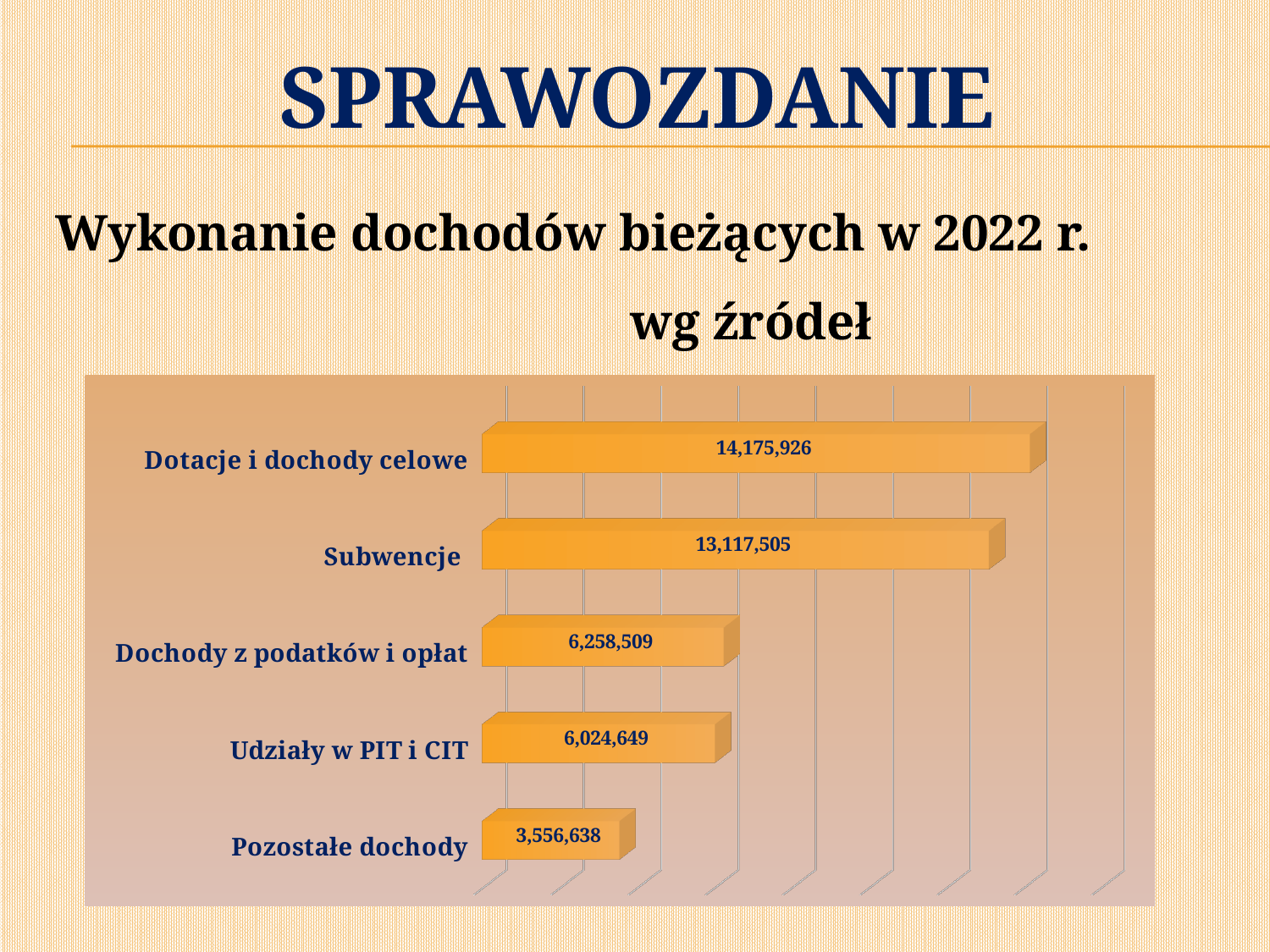
What is the difference between the values for Dochody z podatków i opłat and Udziały w PIT i CIT? 233,860 What is the difference between the values for Dotacje i dochody celowe and Subwencje? 1,058,421 What is the value for Pozostałe dochody? 3,556,638 What is the value for Dochody z podatków i opłat? 6,258,509 What is the value for Udziały w PIT i CIT? 6,024,649 What is the value for Dotacje i dochody celowe? 14,175,926 Which category has the lowest value? Pozostałe dochody What is the value for Subwencje? 13,117,505 How many categories are shown in the chart? 5 What kind of chart is shown on the slide? Bar chart Which is larger, the value for Subwencje or the value for Pozostałe dochody? Subwencje Which category has the highest value? Dotacje i dochody celowe